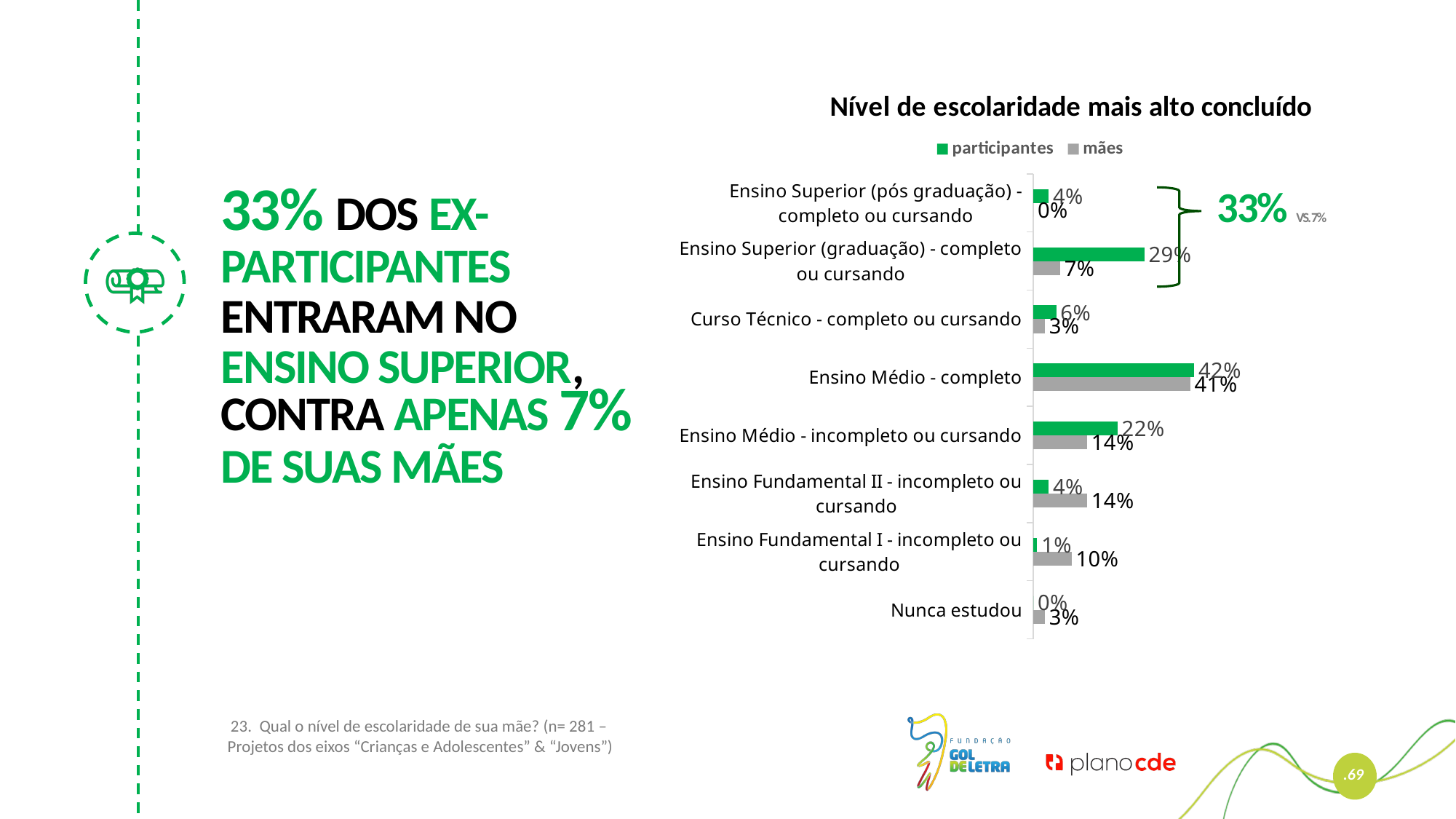
Which category has the lowest value for mães? Ensino Superior (pós graduação) - completo ou cursando What is the value for participantes in the 'Ensino Superior (graduação) - completo ou cursando' category? 29% What is the title of the chart? Nível de escolaridade mais alto concluído In the 'Ensino Fundamental II - incompleto ou cursando' category, which series has the larger value, participantes or mães? mães What is the value for mães in the 'Ensino Médio - completo' category? 41% In the 'Ensino Médio - incompleto ou cursando' category, which series has the larger value, participantes or mães? participantes What is the value for mães in the 'Ensino Fundamental I - incompleto ou cursando' category? 10% How many categories are shown on the chart? 8 What kind of chart is shown on the slide? Bar chart How many series does the legend list? 2 What is the difference between participantes and mães in the 'Ensino Superior (graduação) - completo ou cursando' category? 22% Which category has the highest value for participantes? Ensino Médio - completo